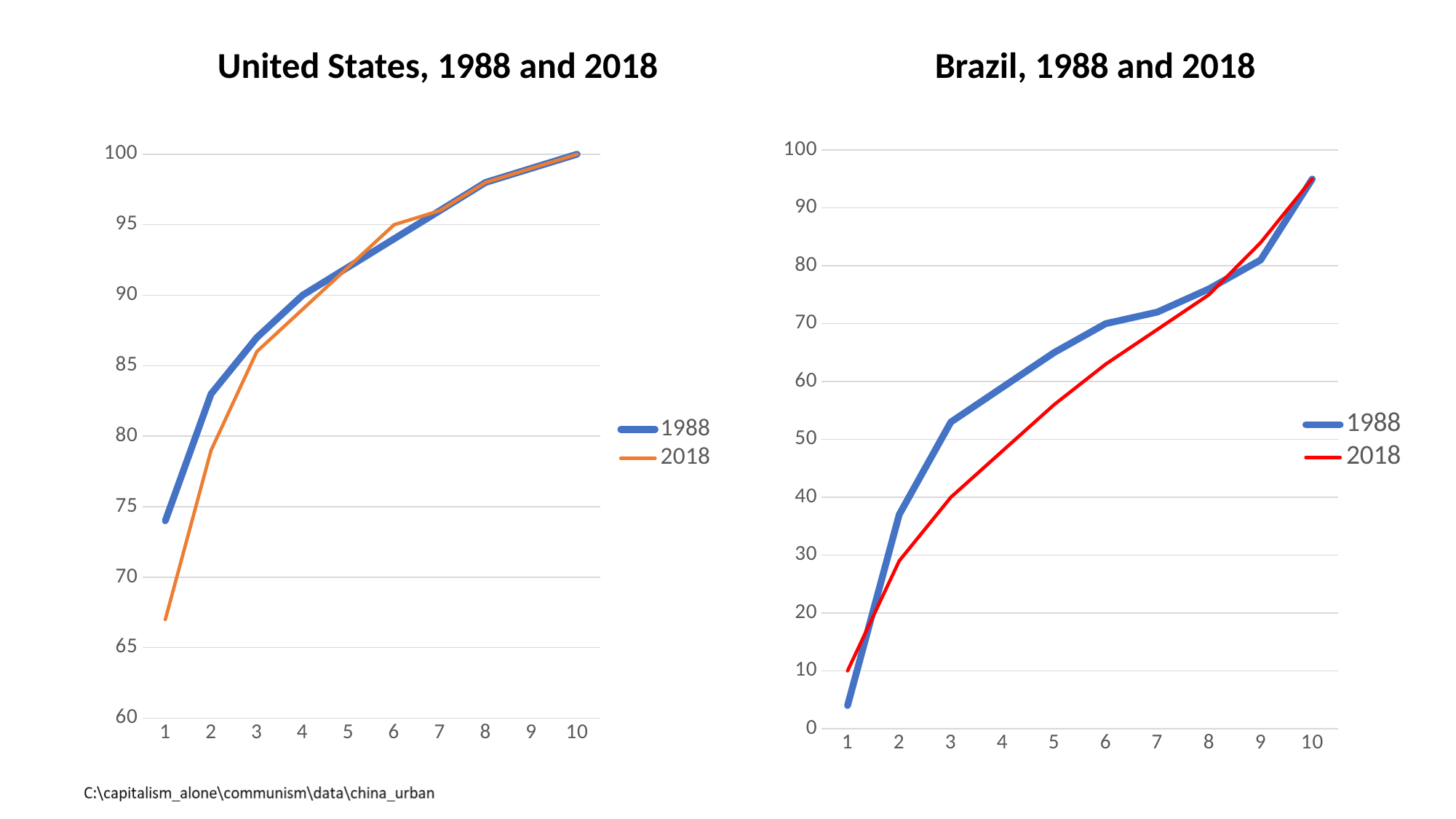
In the 'United States, 1988 and 2018' chart, what is the value of the 1988 series at x = 10? 100 What colour is the 2018 series line in the 'Brazil, 1988 and 2018' chart? red In the 'United States, 1988 and 2018' chart, which series has the larger value at x = 2, 1988 or 2018? 1988 What kind of chart is the 'United States, 1988 and 2018' chart? line chart In the 'United States, 1988 and 2018' chart, is the value of the 2018 series at x = 1 greater or less than 70? less In the 'Brazil, 1988 and 2018' chart, at which x value is the 1988 series lowest? 1 How many points are plotted along the x axis in the 'United States, 1988 and 2018' chart? 10 In the 'Brazil, 1988 and 2018' chart, is the value of the 1988 series at x = 1 greater or less than 10? less How many series does the legend of the 'Brazil, 1988 and 2018' chart list? 2 In the 'Brazil, 1988 and 2018' chart, which series has the larger value at x = 4, 1988 or 2018? 1988 In the 'Brazil, 1988 and 2018' chart, is the value of the 2018 series at x = 9 greater or less than 80? greater In the 'United States, 1988 and 2018' chart, do the values of the 1988 series rise or fall from x = 1 to x = 10? rise